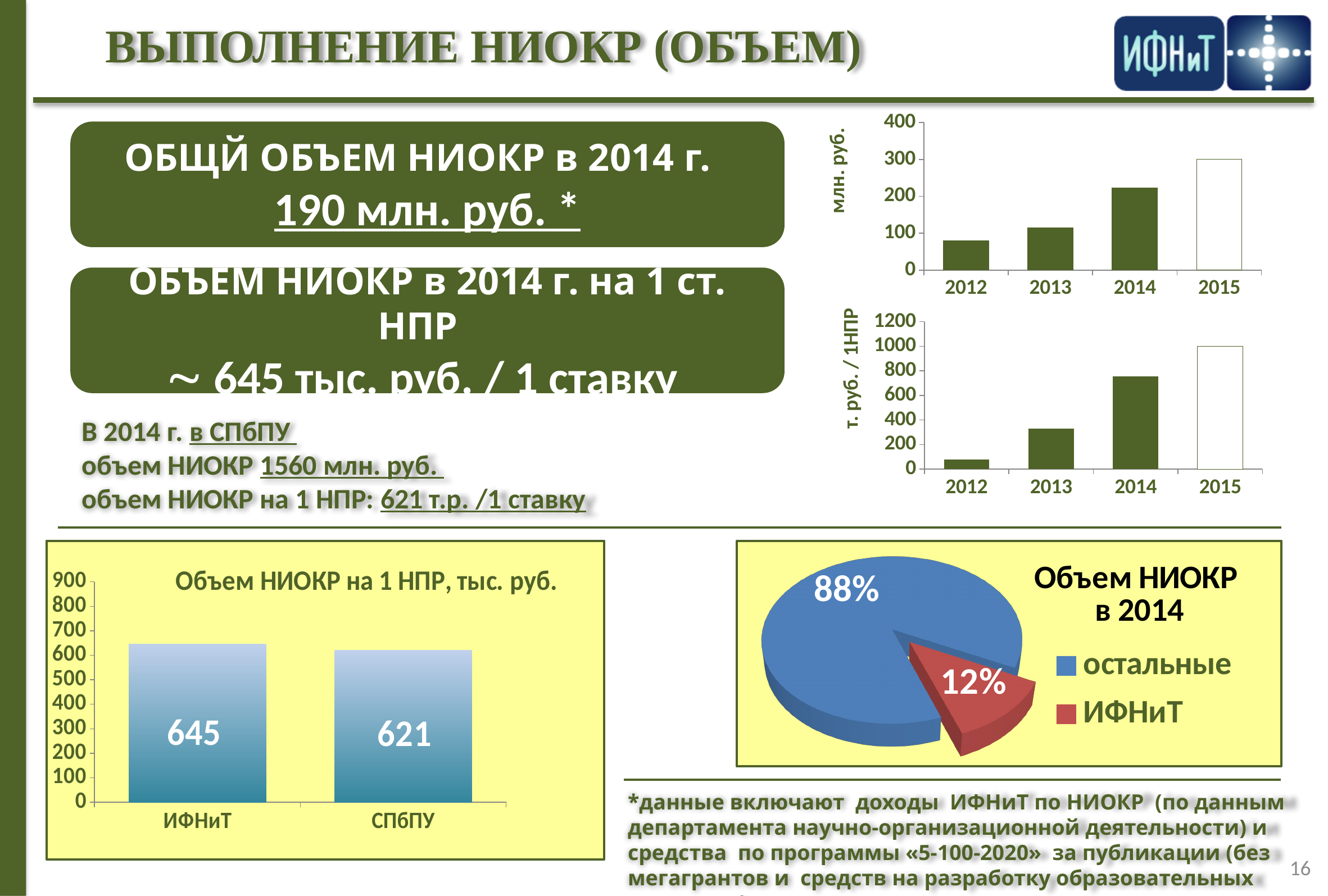
In the bottom-left chart 'Объем НИОКР на 1 НПР, тыс. руб.', which category has the higher value, ИФНиТ or СПбПУ? ИФНиТ In the pie chart 'Объем НИОКР в 2014', what share does ИФНиТ have? 12% In the top-right upper bar chart (млн. руб.), is the value for 2014 greater or less than 200? greater In the bottom-left chart 'Объем НИОКР на 1 НПР, тыс. руб.', what is the value for СПбПУ? 621 In the bottom-left chart 'Объем НИОКР на 1 НПР, тыс. руб.', what is the value for ИФНиТ? 645 In the top-right lower bar chart (т. руб. / 1НПР), do the values rise or fall from 2012 to 2015? rise What kind of chart is the top-right upper chart (млн. руб.)? Bar chart In the bottom-left chart 'Объем НИОКР на 1 НПР, тыс. руб.', what is the difference between the ИФНиТ and СПбПУ values? 24 In the bottom-left chart 'Объем НИОКР на 1 НПР, тыс. руб.', how many categories are shown? 2 In the pie chart 'Объем НИОКР в 2014', what share does остальные have? 88% In the pie chart 'Объем НИОКР в 2014', what colour is the ИФНиТ slice? Red In the pie chart 'Объем НИОКР в 2014', how many entries does the legend list? 2